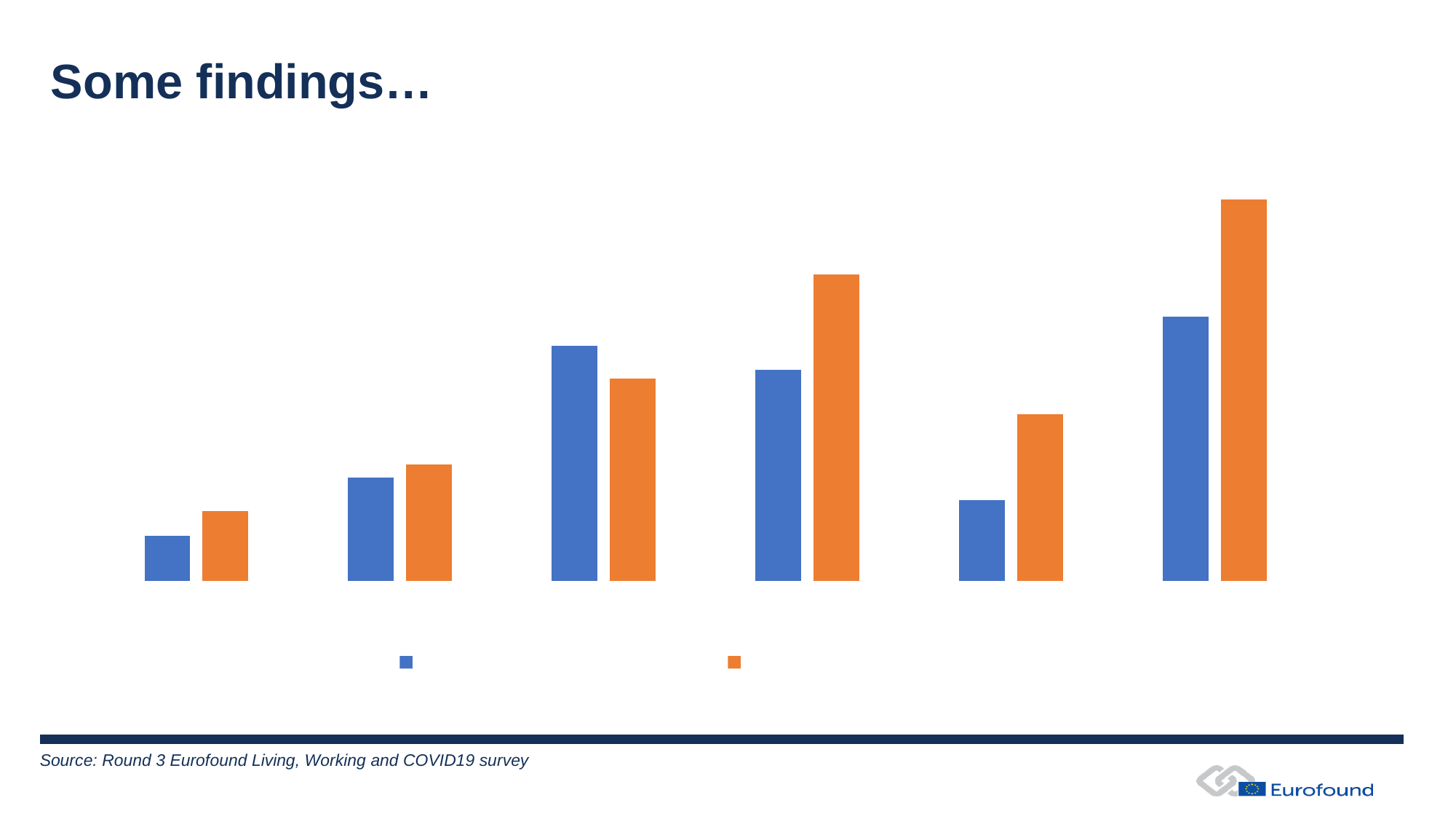
What two colours are used for the bar series? blue and orange How many series does the legend list? 2 Which colour series contains the tallest bar on the chart? orange What is the title of the slide? Some findings… How many bars are plotted in total on the chart? 12 How many groups of bars (categories) does the chart show? 6 Which colour series contains the shortest bar on the chart? blue In how many of the six groups is the orange bar taller than the blue bar? 5 What kind of chart is shown on the slide? bar chart